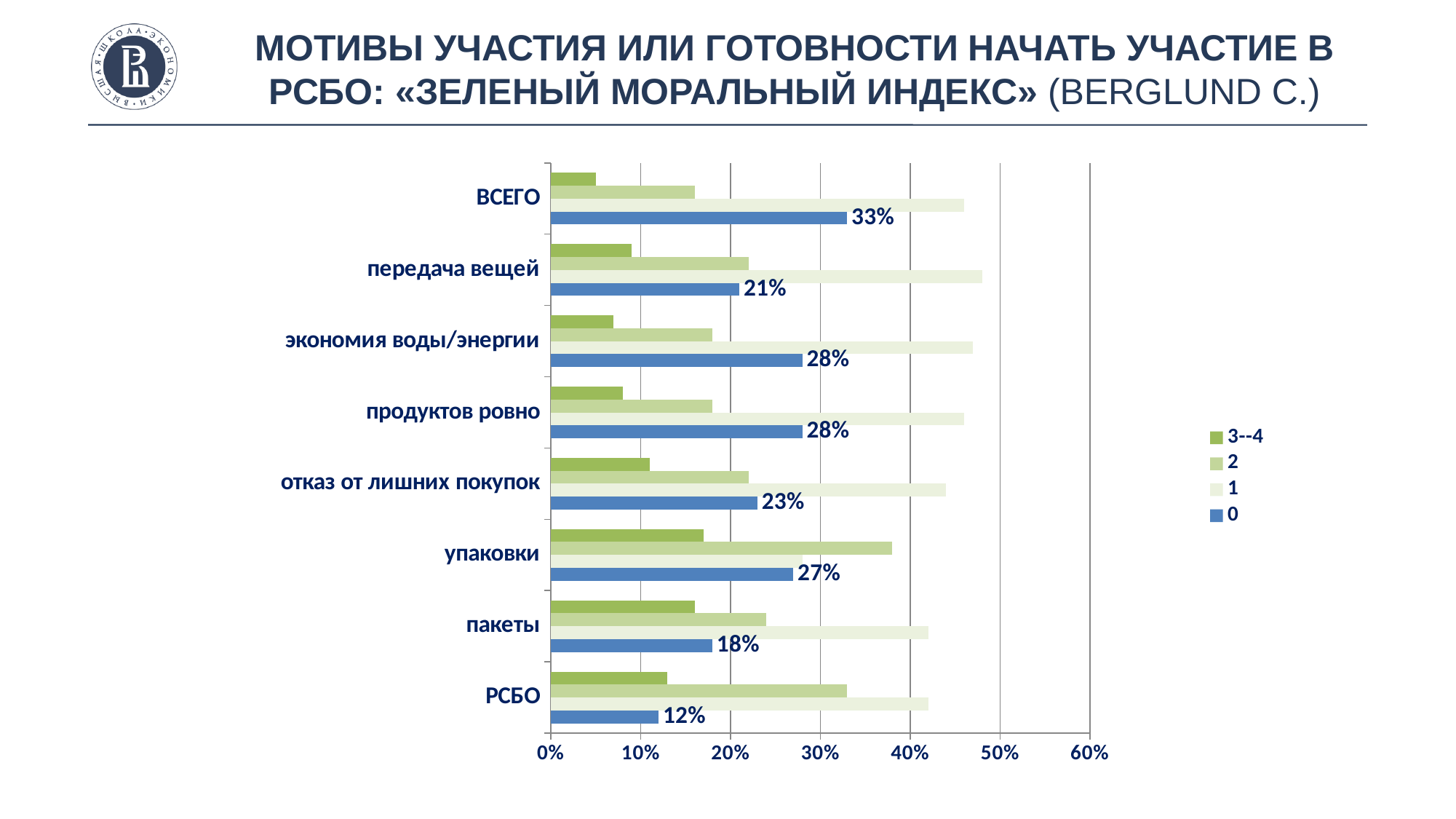
What kind of chart is shown on the slide? Bar chart What is the value of series "0" for пакеты? 18% What is the value of series "0" for упаковки? 27% What is the value of series "0" for ВСЕГО? 33% Which category has the lowest value for series "0"? РСБО Which category has the highest value for series "0"? ВСЕГО How many categories are shown on the chart? 8 Which is larger for series "0": передача вещей or отказ от лишних покупок? отказ от лишних покупок How many series does the legend list? 4 Is the value of series "3--4" for ВСЕГО greater or less than 10%? less Is the value of series "1" for передача вещей greater or less than 40%? greater What is the difference between the series "0" values for ВСЕГО and РСБО? 21%